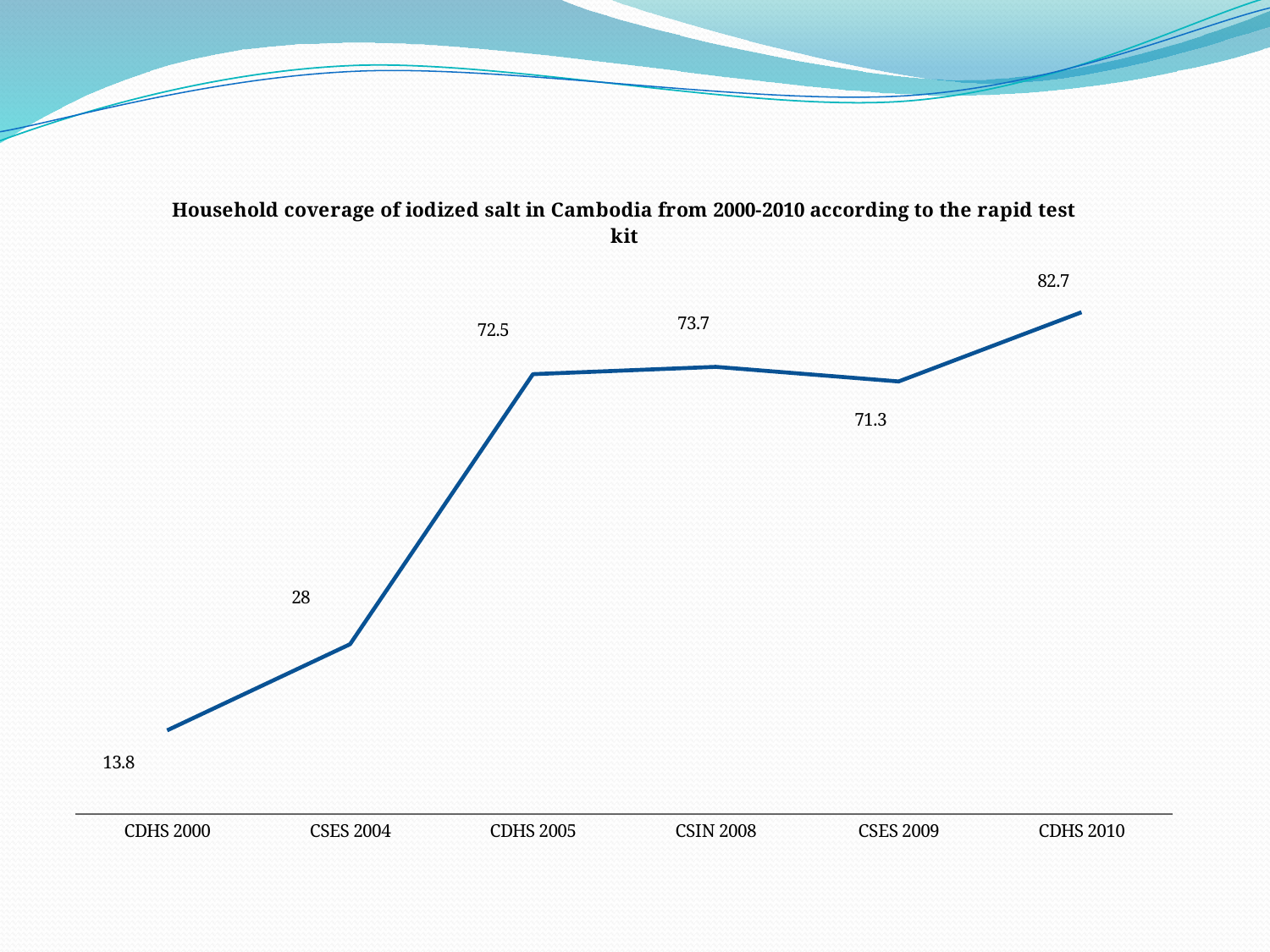
How many data points are plotted on the chart? 6 Which survey has the lowest value? CDHS 2000 Which is larger, the value for CSIN 2008 or the value for CSES 2009? CSIN 2008 What is the value for CSES 2009? 71.3 What is the value for CSIN 2008? 73.7 What is the value for CDHS 2000? 13.8 What is the value for CDHS 2005? 72.5 What is the difference between the values for CDHS 2010 and CDHS 2000? 68.9 What is the value for CDHS 2010? 82.7 What is the value for CSES 2004? 28 Which survey has the highest value? CDHS 2010 What kind of chart is shown on the slide? Line chart